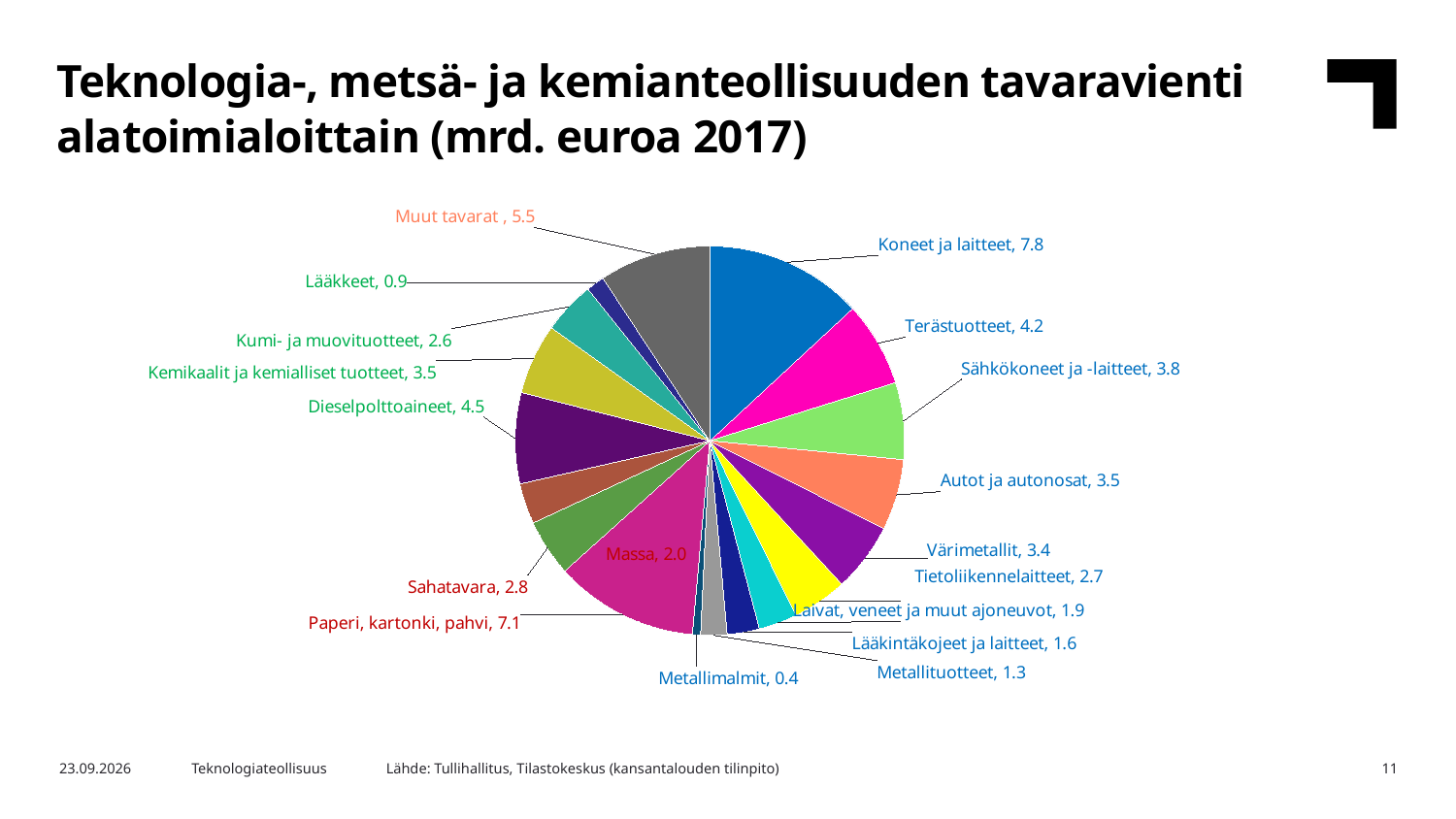
What is the value for Metallimalmit? 0.4 What is the value for Dieselpolttoaineet? 4.5 What is the title of the chart on the slide? Teknologia-, metsä- ja kemianteollisuuden tavaravienti alatoimialoittain (mrd. euroa 2017) Which category has the smallest value in the pie chart? Metallimalmit Which category has the largest value in the pie chart? Koneet ja laitteet How many categories are shown in the pie chart? 18 Which is larger, Dieselpolttoaineet or Terästuotteet? Dieselpolttoaineet What is the value for Paperi, kartonki, pahvi? 7.1 What is the value for Koneet ja laitteet? 7.8 What kind of chart is shown on the slide? Pie chart What is the difference between the values for Terästuotteet and Sähkökoneet ja -laitteet? 0.4 What is the difference between the values for Koneet ja laitteet and Paperi, kartonki, pahvi? 0.7